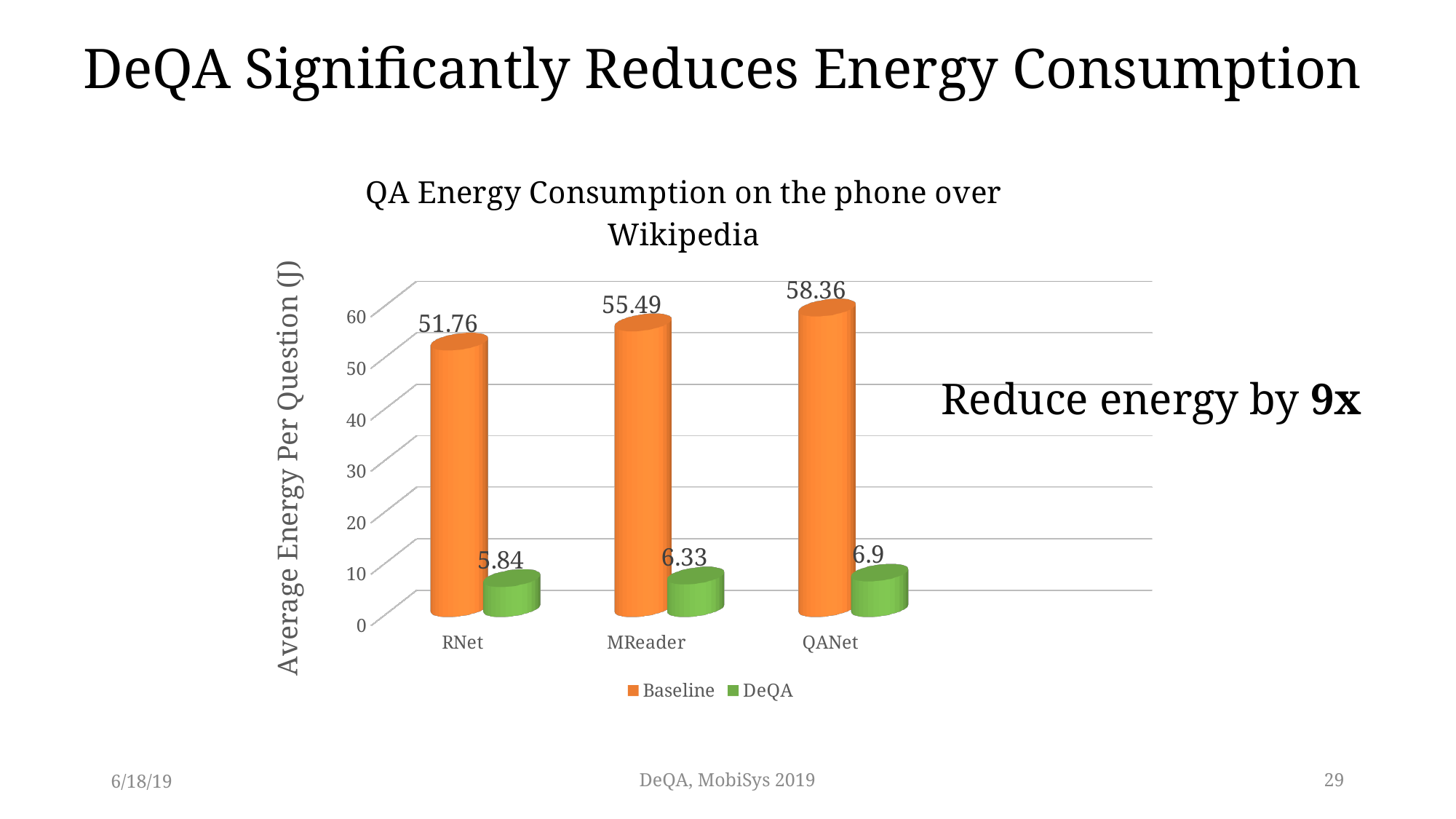
Which model has the lowest DeQA energy consumption? RNet Which model has the highest Baseline energy consumption? QANet What is the DeQA energy consumption for QANet? 6.9 What is the Baseline energy consumption for RNet? 51.76 Is the Baseline value for MReader greater or less than 50? greater Which is larger, the Baseline value for RNet or the Baseline value for QANet? QANet What is the title of the chart? QA Energy Consumption on the phone over Wikipedia What kind of chart is shown on the slide? bar chart What is the difference between the Baseline and DeQA values for MReader? 49.16 How many series does the legend list? 2 What is the DeQA value for MReader? 6.33 How many models are shown on the x axis? 3